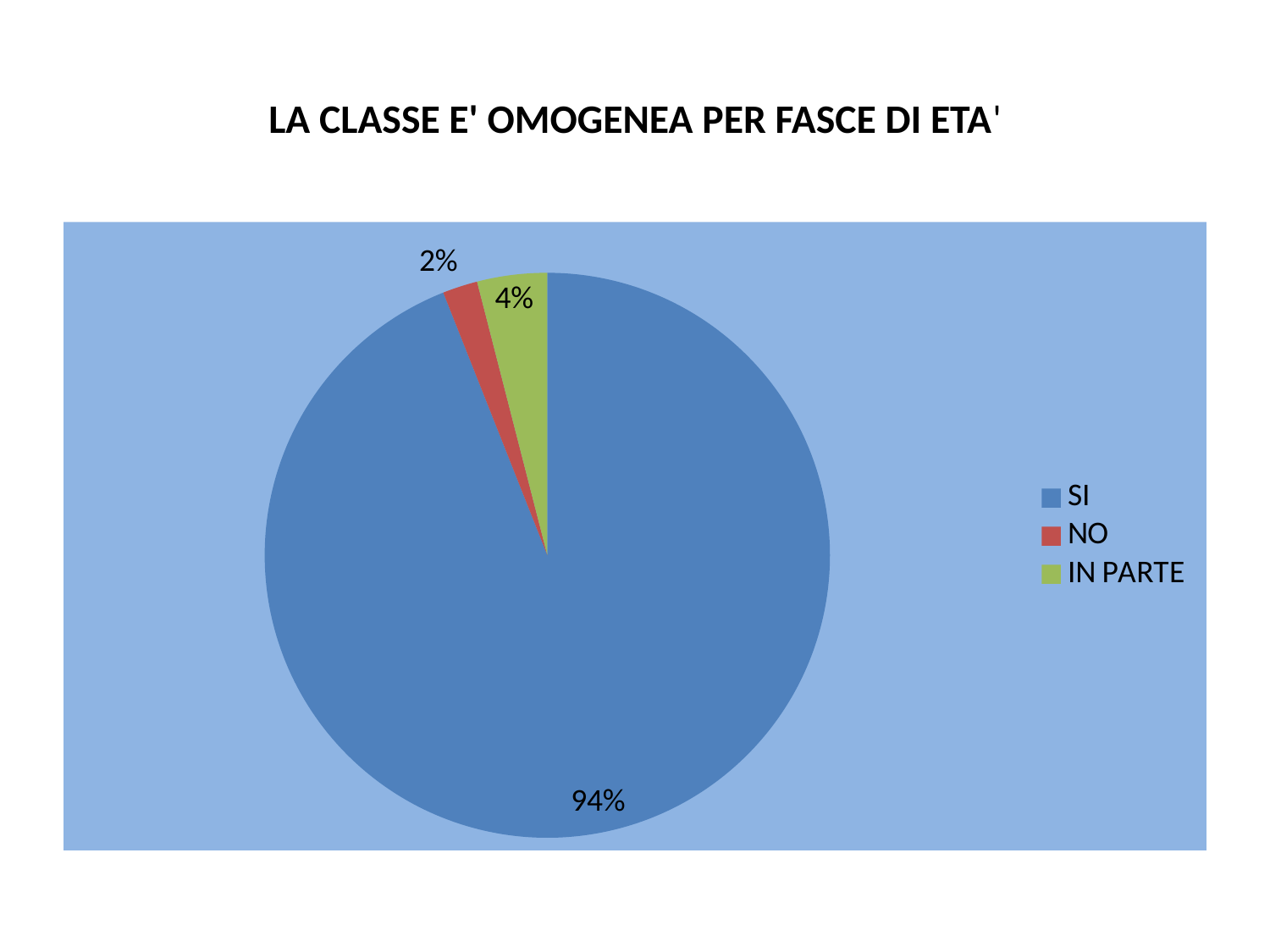
Which category has the largest slice? SI Which category has the smallest slice? NO What share of the pie does NO take? 2% What is the title of the chart? LA CLASSE E' OMOGENEA PER FASCE DI ETA' What share of the pie does IN PARTE take? 4% How many categories does the legend list? 3 What is the difference between the IN PARTE share and the NO share? 2% What is the difference between the SI share and the IN PARTE share? 90% Which is larger, the slice for NO or the slice for IN PARTE? IN PARTE What colour is the slice for NO? red What share of the pie does SI take? 94% What kind of chart is shown on the slide? pie chart